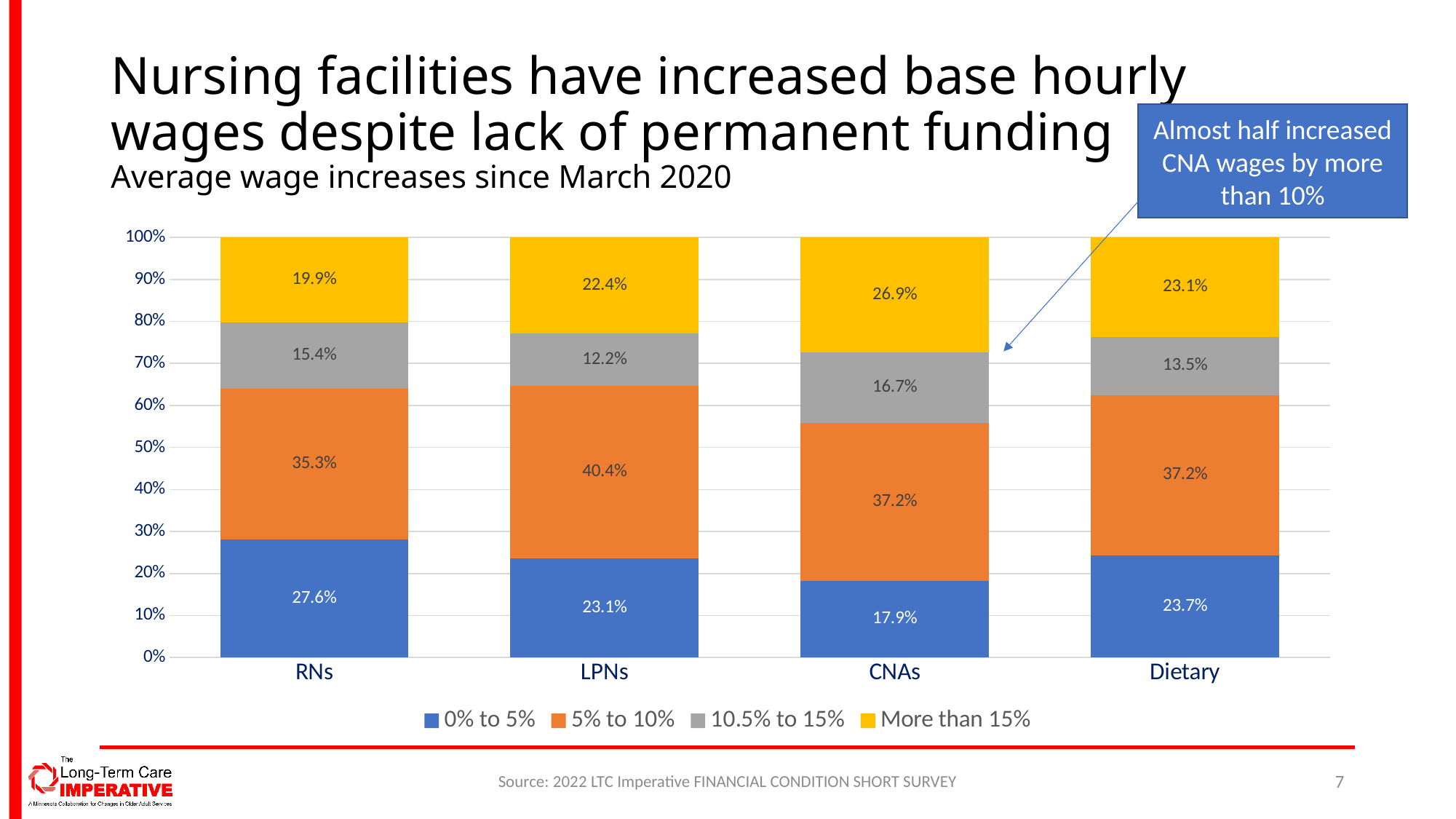
Which category has the lowest value for the 'More than 15%' series? RNs What kind of chart is shown on the slide? Stacked bar chart How many series does the legend list? 4 What is the value of the '5% to 10%' segment for LPNs? 40.4% Which is larger: the '5% to 10%' value for LPNs or for CNAs? LPNs What percentage of facilities increased RN wages by 0% to 5%? 27.6% How many categories are shown on the x axis? 4 What is the difference between the 'More than 15%' values for CNAs and RNs? 7.0% What is the value of the '10.5% to 15%' segment for Dietary? 13.5% Which category has the highest value for the '0% to 5%' series? RNs What is the value of the 'More than 15%' segment for CNAs? 26.9% What is the subtitle shown above the chart? Average wage increases since March 2020